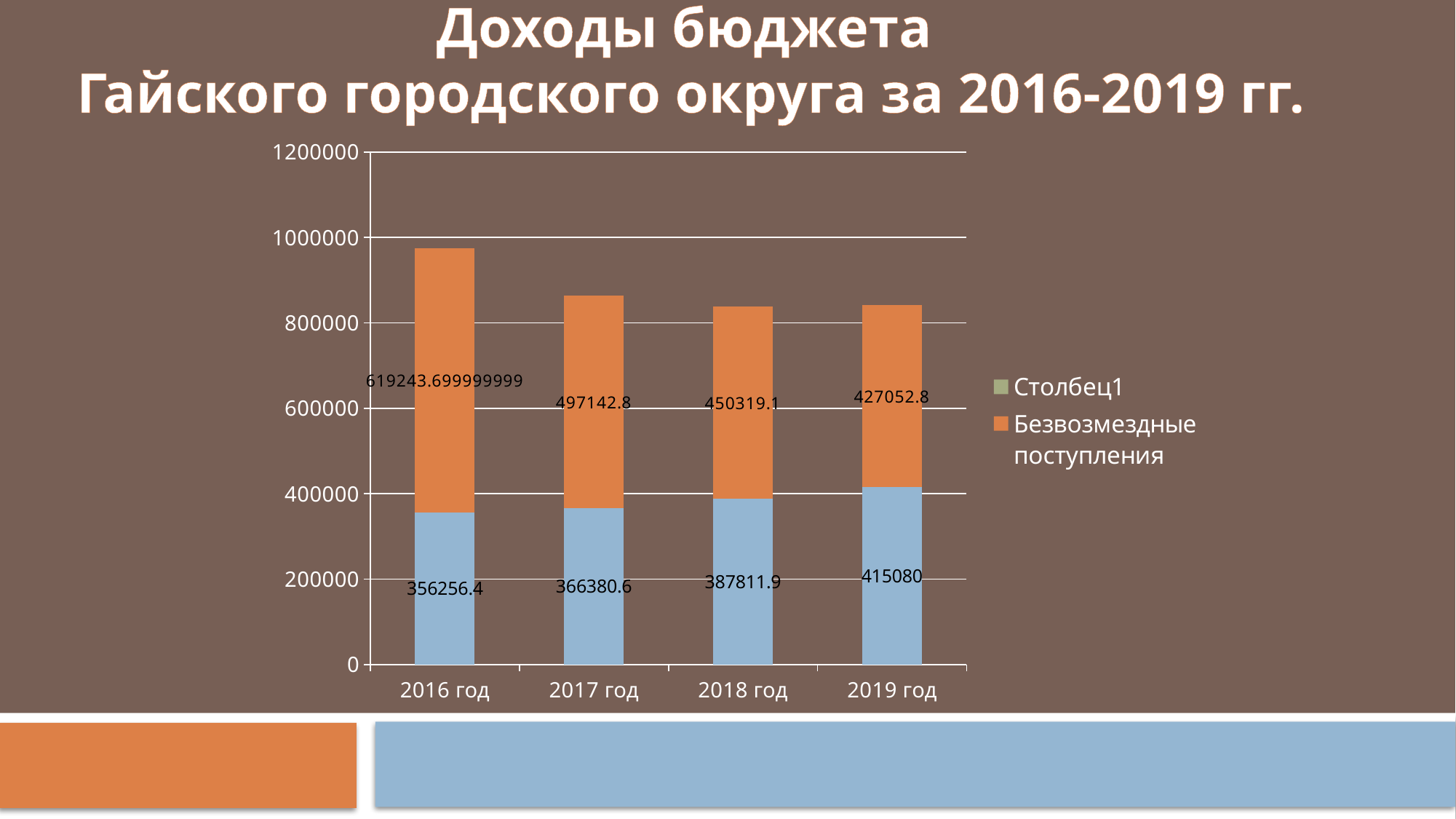
Which year has the lowest value for the blue (bottom) segment? 2016 год Do the values of Безвозмездные поступления rise or fall from 2016 год to 2019 год? fall How many entries does the legend list? 2 What kind of chart is shown on the slide? Stacked bar chart Which year has the highest value for Безвозмездные поступления? 2016 год For 2019 год, which is larger: the blue (bottom) segment or Безвозмездные поступления? Безвозмездные поступления What is the total of the stacked bar for 2017 год? 863523.4 What is the value of Безвозмездные поступления for 2017 год? 497142.8 What is the difference between the Безвозмездные поступления values for 2017 год and 2018 год? 46823.7 How many years are shown on the x axis? 4 Do the values of the blue (bottom) segment rise or fall from 2016 год to 2019 год? rise What is the value of the blue (bottom) segment for 2019 год? 415080